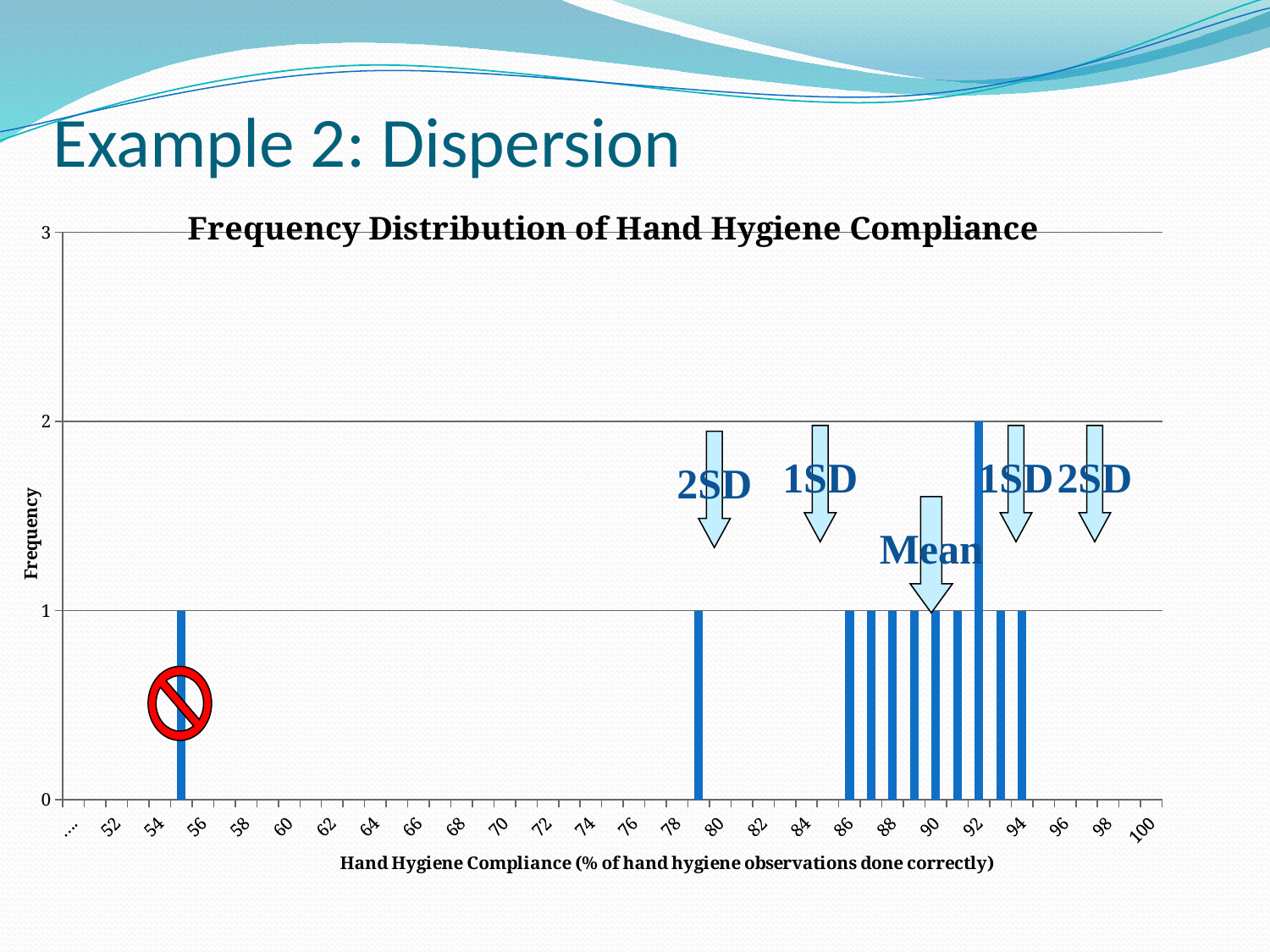
Is the frequency at a hand hygiene compliance of 92 greater or less than 1? greater What is the frequency at a hand hygiene compliance of 94? 1 What is the label of the vertical axis? Frequency What is the frequency at a hand hygiene compliance of 90? 1 What is the difference between the frequency at 92 and the frequency at 90? 1 Which hand hygiene compliance value has the highest frequency? 92 What is the frequency at a hand hygiene compliance of 86? 1 What is the title of the chart? Frequency Distribution of Hand Hygiene Compliance What type of chart is shown on the slide? bar chart What is the frequency at a hand hygiene compliance of 92? 2 How many bars are plotted in the chart? 11 Which has the higher frequency, a compliance of 92 or a compliance of 88? 92